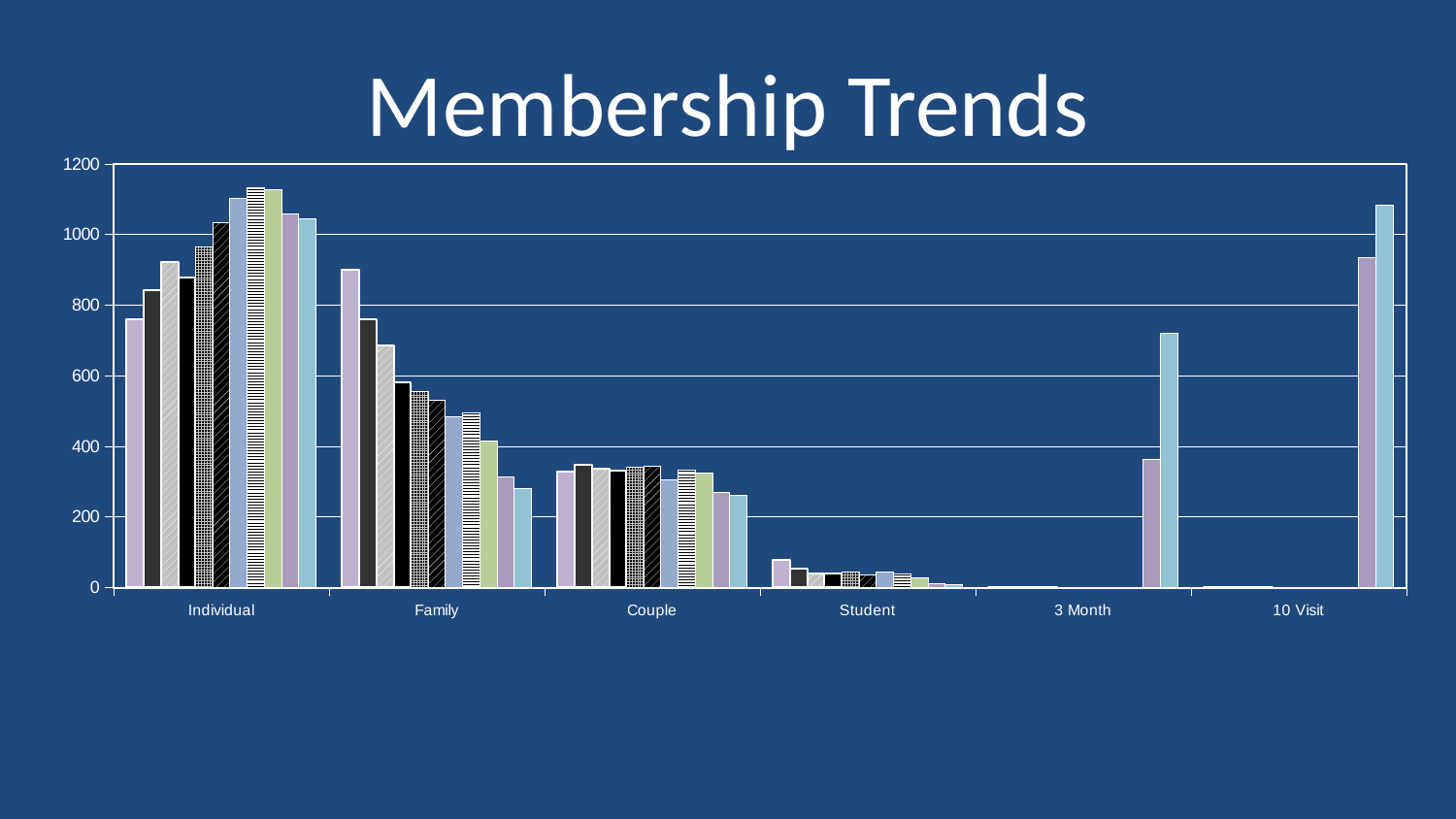
Which membership category has the tallest bar overall? Individual Do the bars in the Family category rise or fall from left to right? fall Are the bars in the Couple category greater or less than 400? less What kind of chart is shown on the slide? bar chart What is the title of the chart? Membership Trends How many membership categories are shown on the x axis? 6 Is the tallest bar in the Individual category greater or less than 1000? greater Is the tallest bar in the 3 Month category greater or less than 600? greater Which has the taller bars, the Couple category or the Student category? Couple